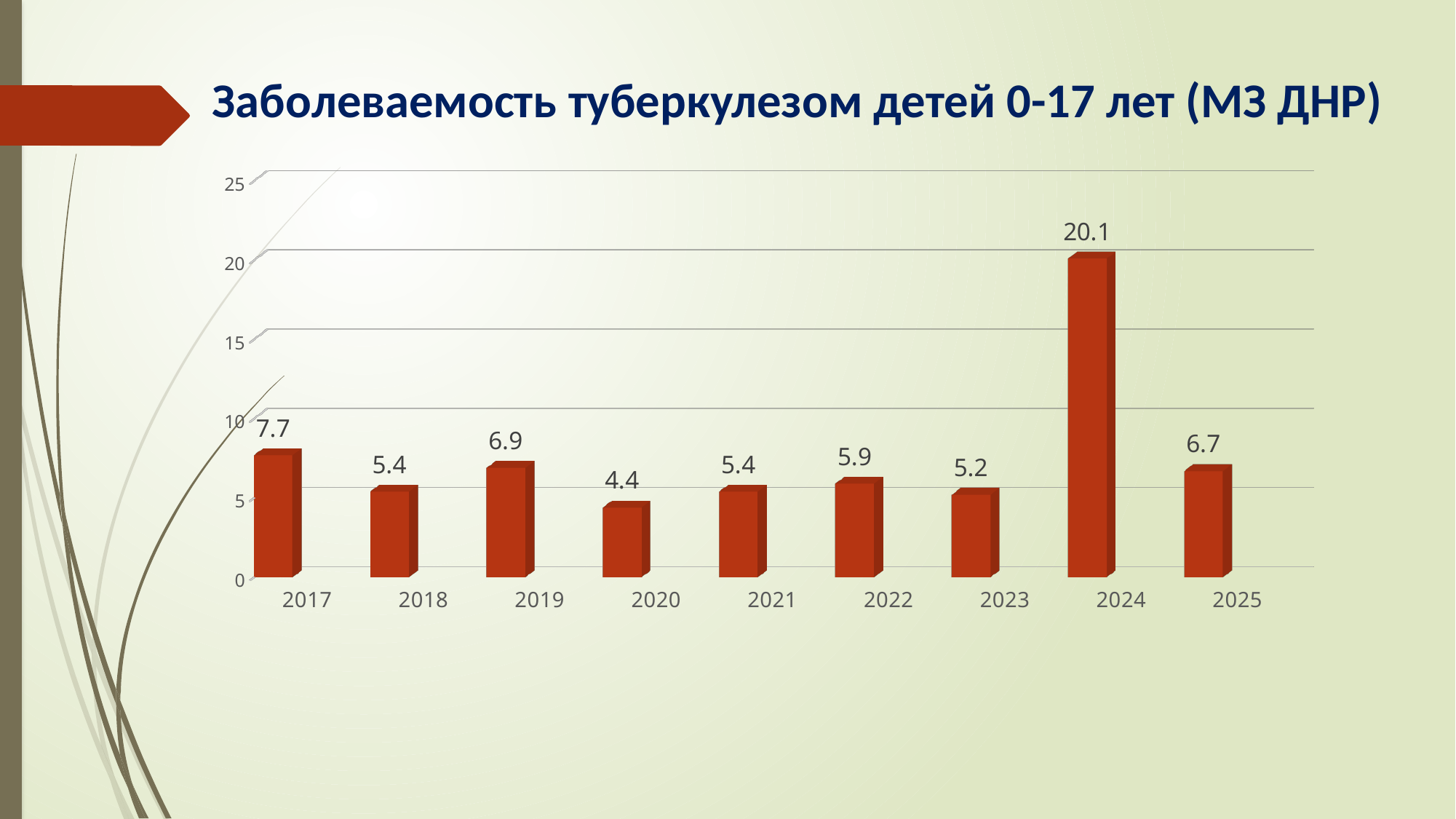
How many years are shown on the x axis? 9 What kind of chart is shown on the slide? bar chart What is the difference between the values for 2024 and 2023? 14.9 What is the difference between the values for 2017 and 2018? 2.3 Is the value for 2024 greater or less than 15? greater Which is larger, the value for 2019 or the value for 2025? 2019 What is the value for 2020? 4.4 Which year has the highest value? 2024 What is the value for 2024? 20.1 What is the title of the chart? Заболеваемость туберкулезом детей 0-17 лет (МЗ ДНР) Which year has the lowest value? 2020 What is the value for 2017? 7.7